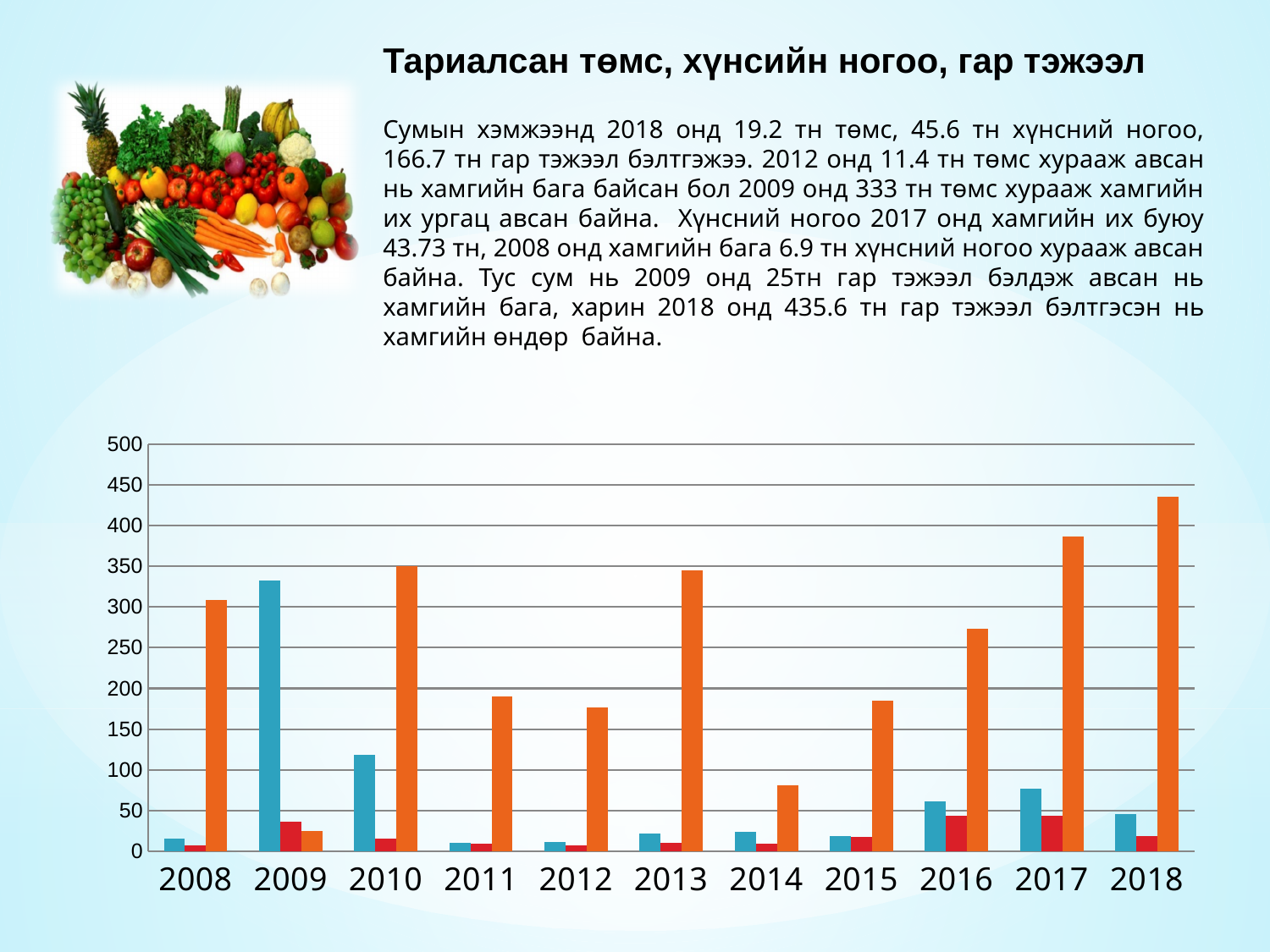
Is the orange bar for 2014 greater or less than 100? less What is the highest value shown on the vertical axis of the chart? 500 How many years are shown on the x axis of the chart? 11 Which is taller, the orange bar for 2016 or the orange bar for 2017? 2017 In which year is the blue bar the tallest? 2009 In which year is the orange bar the tallest? 2018 What kind of chart is shown on the slide? bar chart In which year is the orange bar the shortest? 2009 Is the orange bar for 2009 greater or less than 50? less Do the orange bars rise or fall from 2015 to 2018? rise Is the blue bar for 2009 greater or less than 300? greater